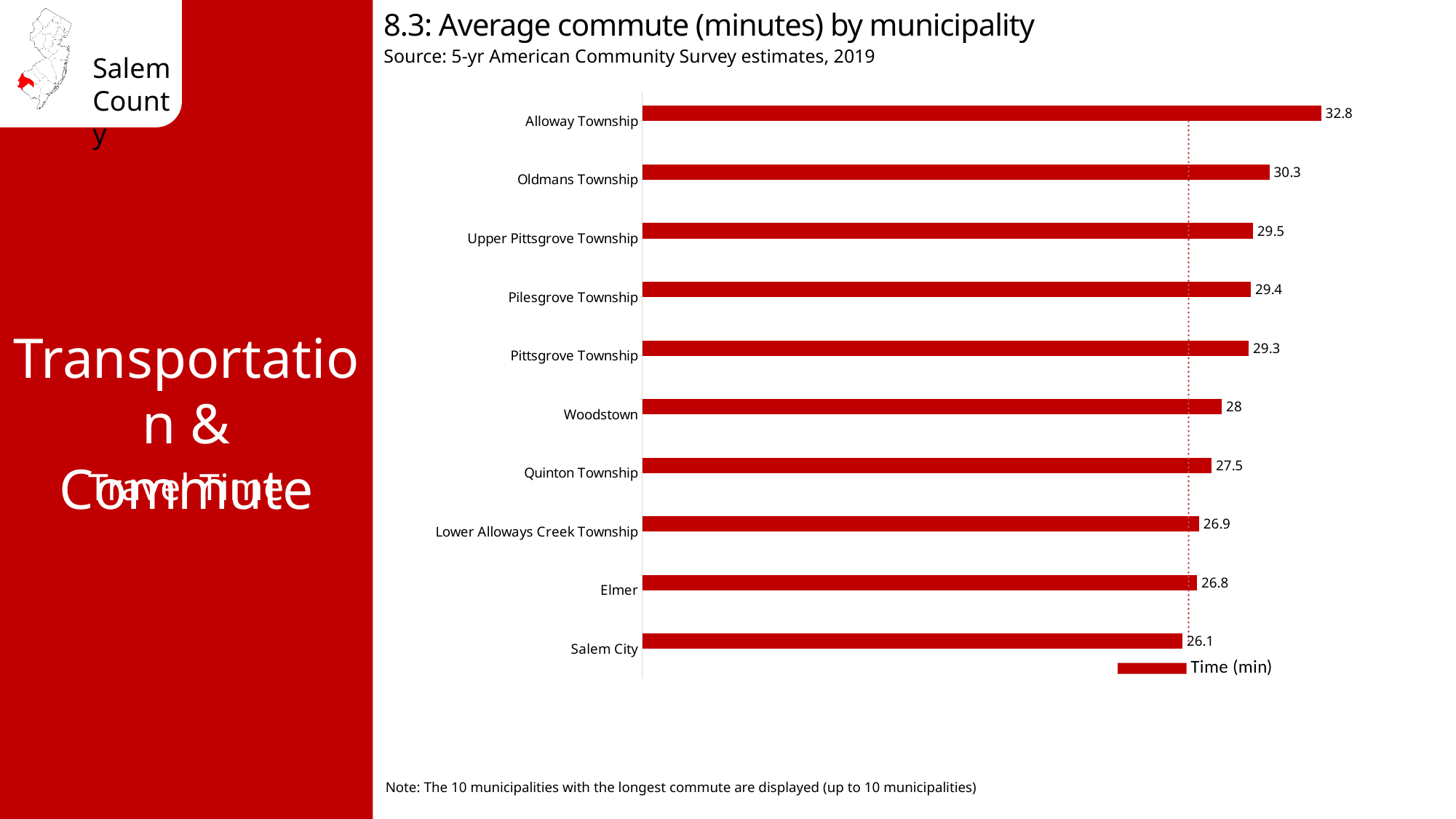
What is the average commute time for Woodstown? 28 What is the title of the chart? 8.3: Average commute (minutes) by municipality How many municipalities are shown in the chart? 10 What kind of chart is shown on the slide? Bar chart Which municipality has the longest average commute? Alloway Township Which has a longer average commute, Quinton Township or Pittsgrove Township? Pittsgrove Township What is the difference in average commute time between Alloway Township and Salem City? 6.7 What is the difference in average commute time between Oldmans Township and Elmer? 3.5 What is the average commute time for Alloway Township? 32.8 Which municipality has the shortest average commute among those shown? Salem City What is the average commute time for Lower Alloways Creek Township? 26.9 How many series does the legend list? 1